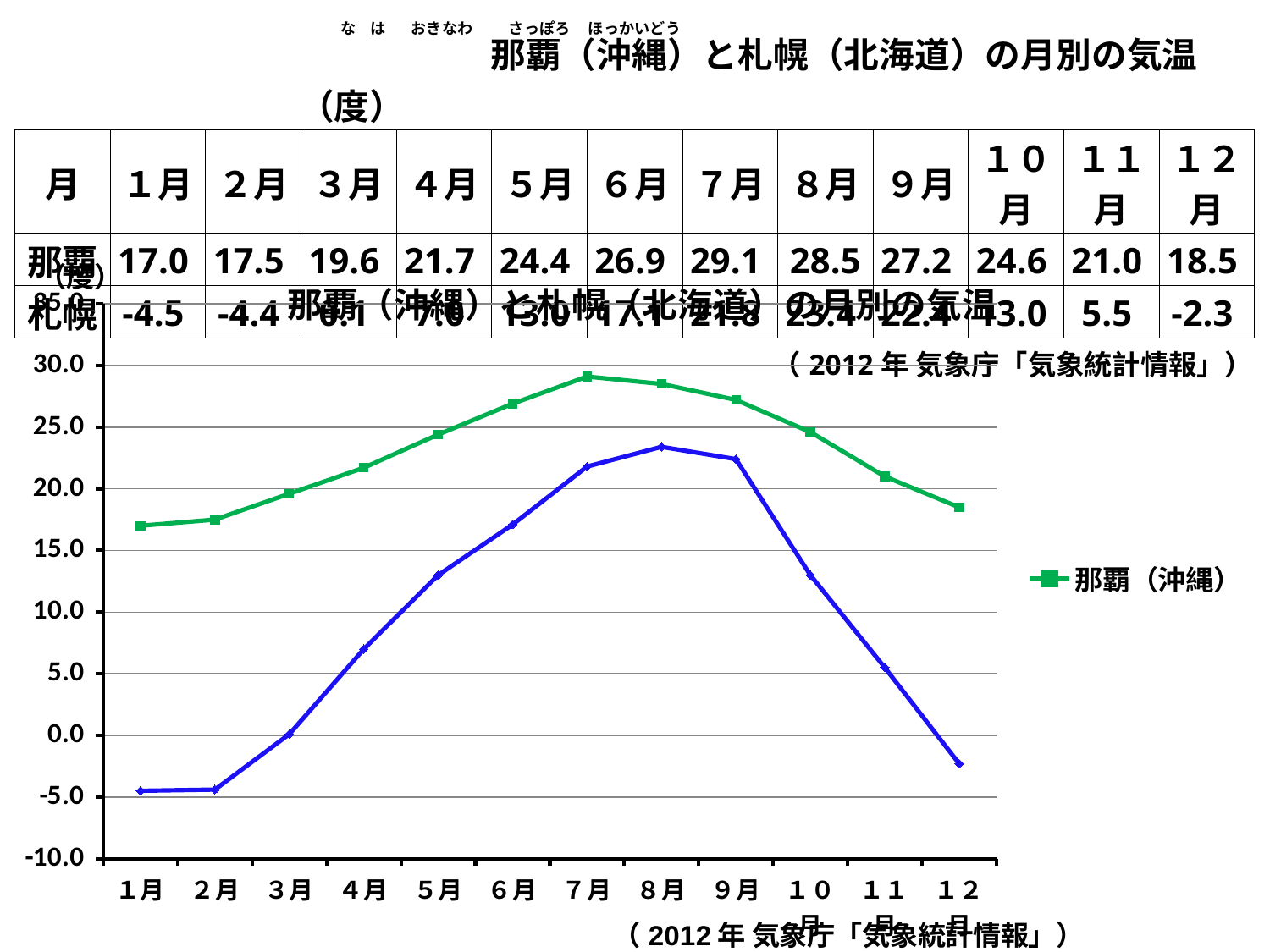
Which is higher in 8月, the temperature for 那覇（沖縄） or for 札幌? 那覇（沖縄） In which month is the temperature for 那覇（沖縄） highest? 7月 What kind of chart is shown on the slide? line chart What is the temperature for 札幌 in 1月? -4.5 What is the temperature for 札幌 in 12月? -2.3 Does the 那覇（沖縄） line rise or fall from 1月 to 7月? rise How many months are plotted along the x axis of the chart? 12 In which month is the temperature for 那覇（沖縄） lowest? 1月 Is the value for 札幌 in 7月 greater or less than 20.0? greater What is the difference between the 那覇（沖縄） temperature in 7月 and in 1月? 12.1 What is the temperature for 那覇（沖縄） in 7月? 29.1 What is the difference between the 札幌 temperature in 11月 and in 12月? 7.8